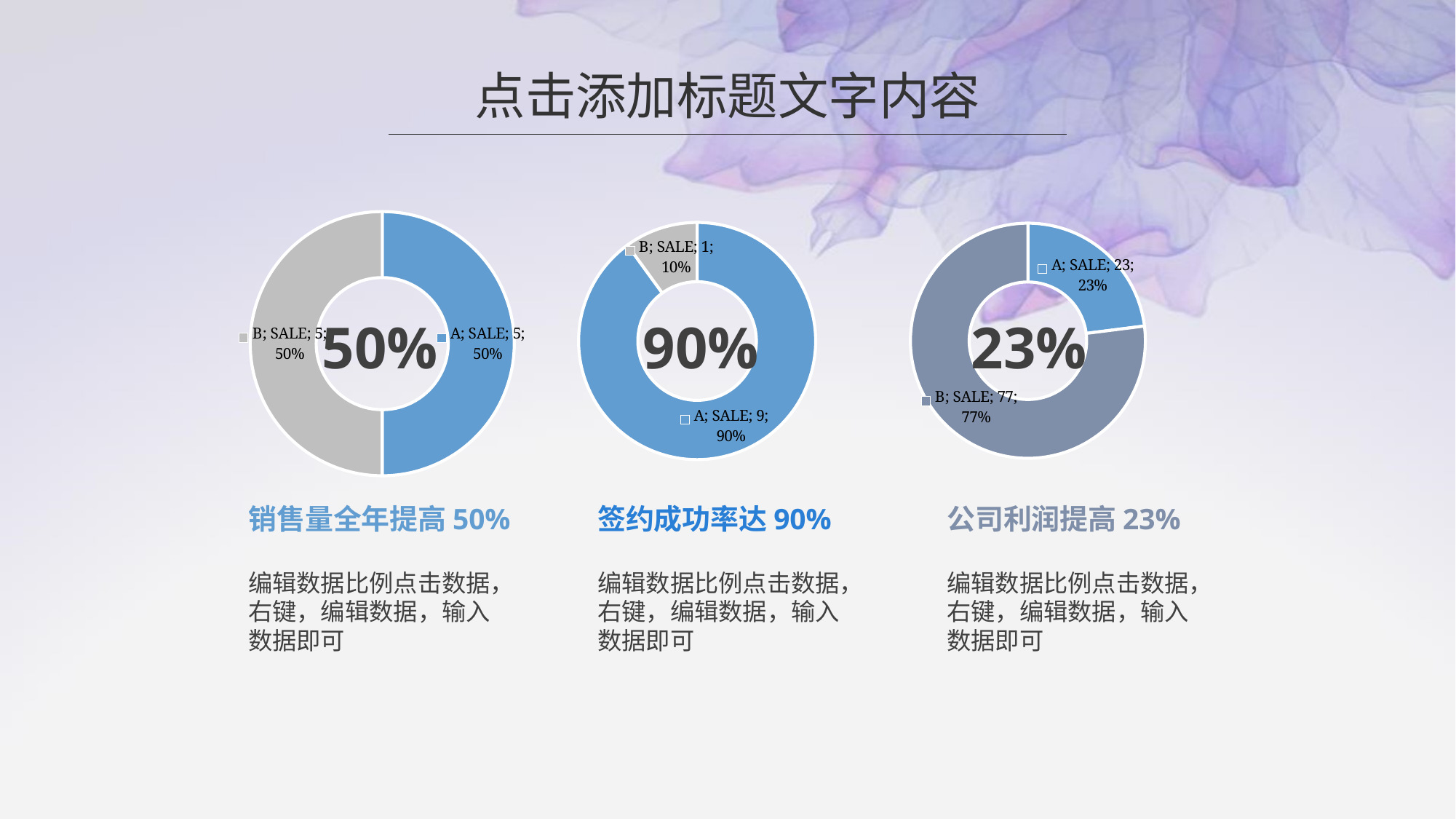
How many slices does the left chart have? 2 In the left chart, what is the value for B? 5 What kind of chart is the left chart on the slide? doughnut chart In the middle chart, which slice is the largest? A In the right chart, which slice is the smallest? A In the left chart, what share of the doughnut does slice A have? 50% In the middle chart, what is the value for A? 9 In the right chart, what is the value for B? 77 In the right chart, what is the difference between the values for B and A? 54 In the middle chart, what is the difference between the values for A and B? 8 In the right chart, what share of the doughnut does slice A have? 23% In the middle chart, what share of the doughnut does slice B have? 10%